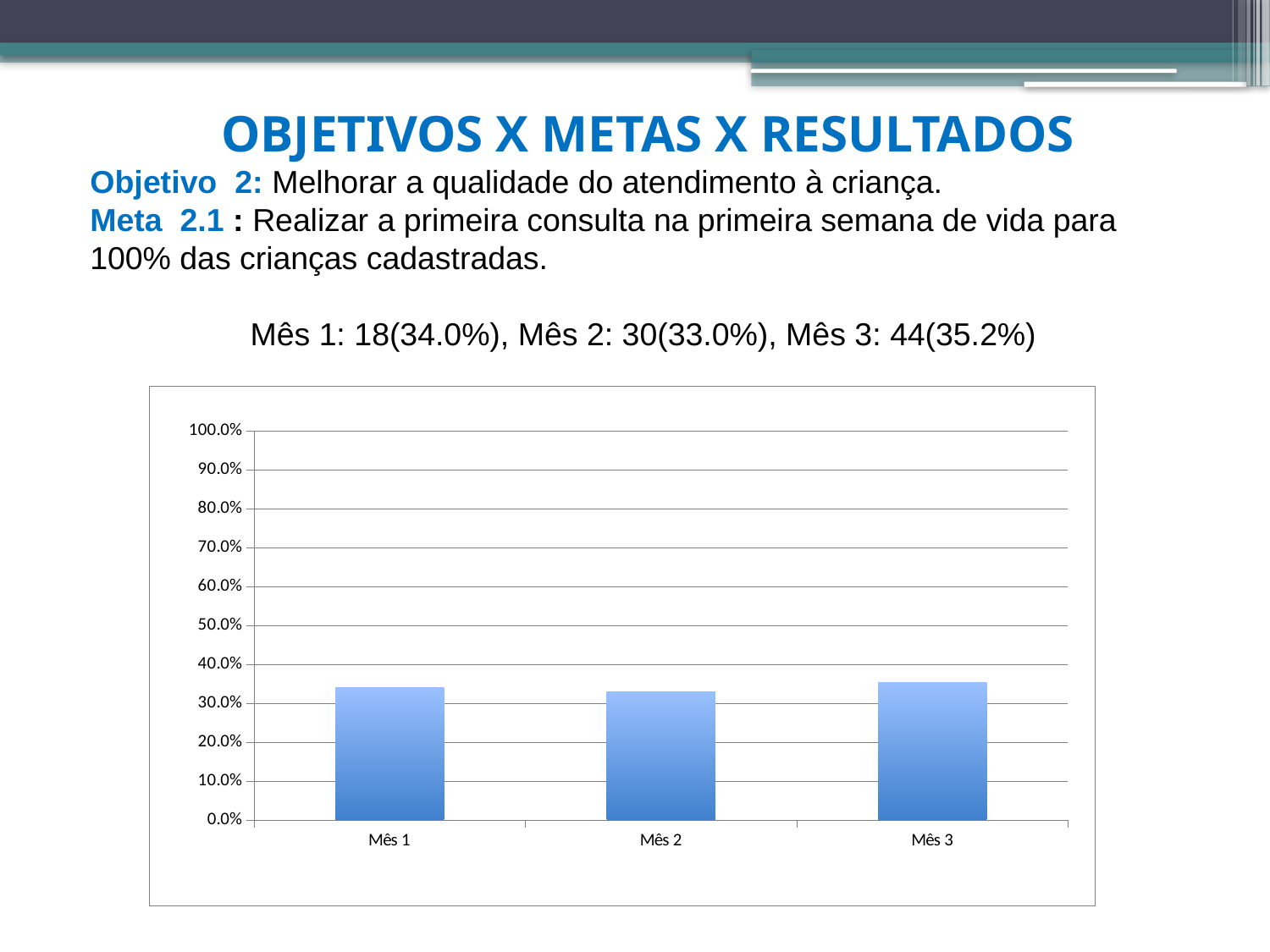
What is the percentage value for Mês 2? 33.0% Is the value for Mês 1 greater or less than 40.0%? less What is the difference in percentage points between Mês 3 and Mês 2? 2.2 What kind of chart is shown on the slide? bar chart Is the value for Mês 3 greater or less than 30.0%? greater What is the percentage value for Mês 1? 34.0% Which month has the lowest percentage in the chart? Mês 2 Which month has the highest percentage in the chart? Mês 3 What is the highest value shown on the vertical axis of the chart? 100.0% What is the percentage value for Mês 3? 35.2% How many categories (months) are plotted in the chart? 3 Which is larger, the value for Mês 1 or the value for Mês 2? Mês 1